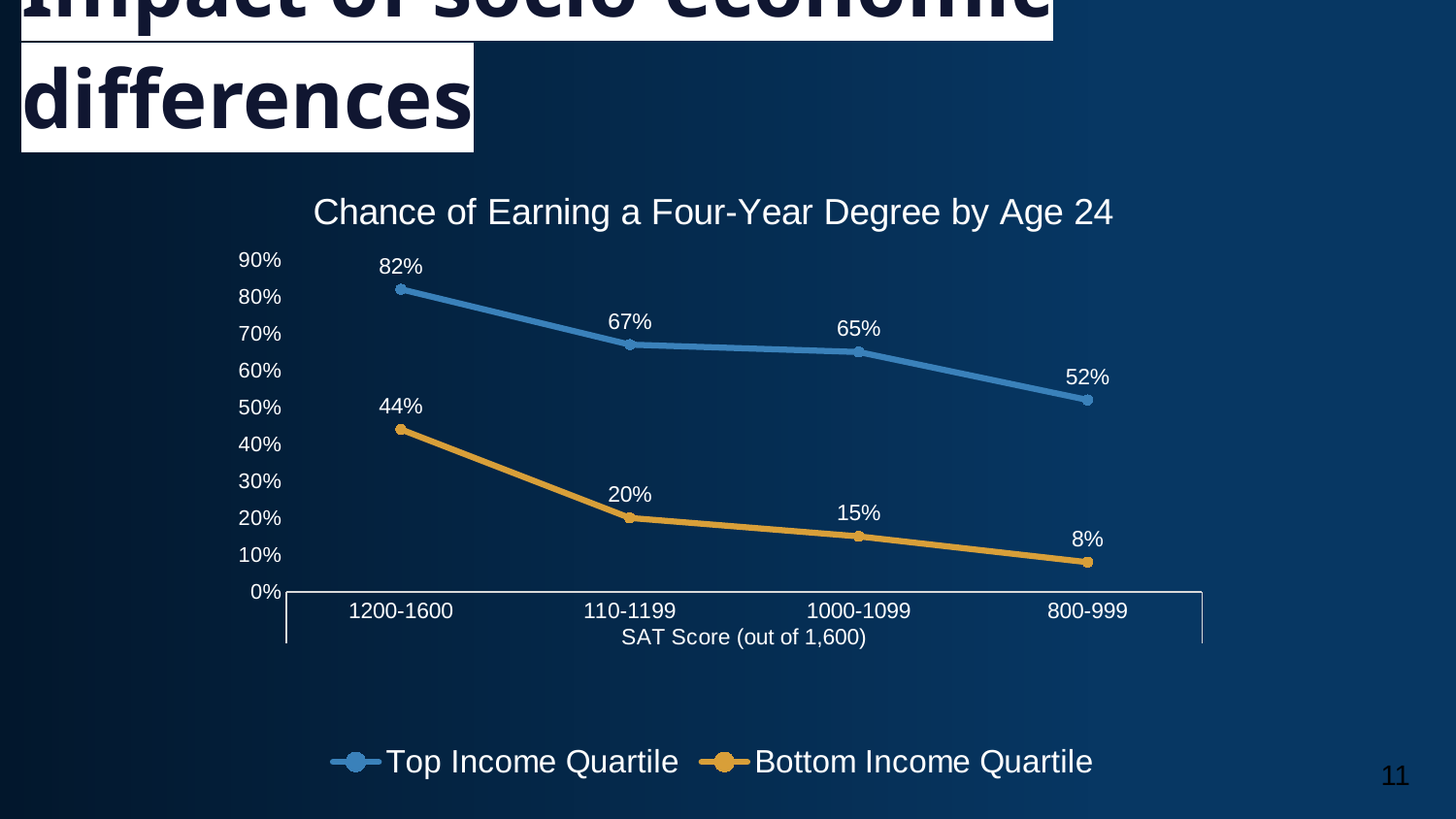
What is the value for the Bottom Income Quartile at the 800-999 SAT score range? 8% What is the value for the Top Income Quartile at the 800-999 SAT score range? 52% What is the value for the Bottom Income Quartile at the 1000-1099 SAT score range? 15% What is the difference between the Top Income Quartile and Bottom Income Quartile values at the 1200-1600 SAT score range? 38% What is the chance of earning a four-year degree by age 24 for the Top Income Quartile with an SAT score of 1200-1600? 82% Do the values for the Top Income Quartile rise or fall from left to right along the x axis? Fall Which series has the larger value at the 110-1199 SAT score range, Top Income Quartile or Bottom Income Quartile? Top Income Quartile How many SAT score ranges are shown on the x axis? 4 What kind of chart is shown on the slide? Line chart Which SAT score range has the highest value for the Bottom Income Quartile? 1200-1600 Which SAT score range has the lowest value for the Top Income Quartile? 800-999 How many series does the legend list? 2